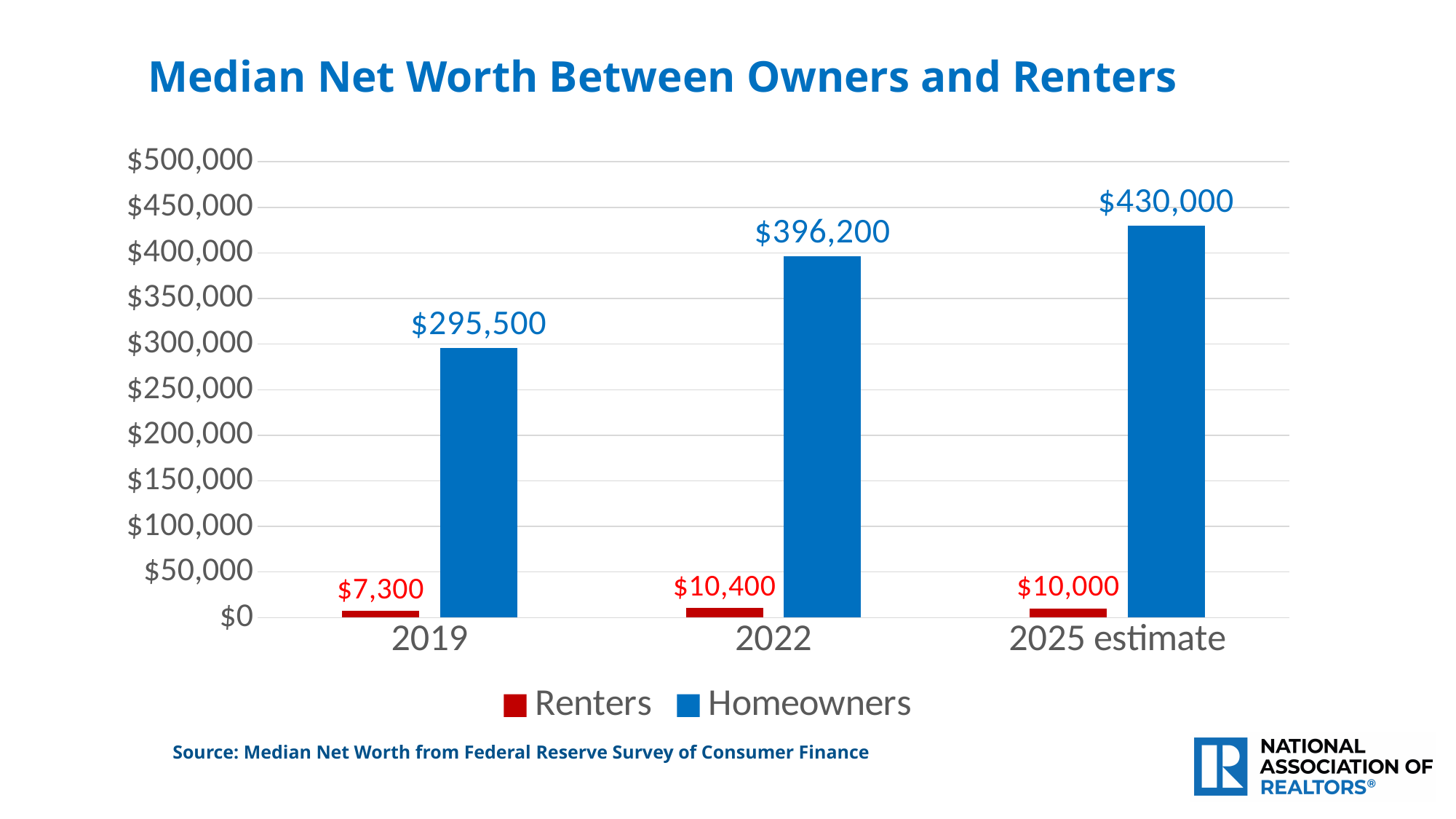
How many series does the legend list? 2 What is the difference between Homeowners and Renters median net worth in 2019? $288,200 Which is larger, the Renters value in 2022 or the Renters value in the 2025 estimate? 2022 Do the Homeowners values rise or fall from 2019 to the 2025 estimate? rise What is the median net worth of Homeowners in the 2025 estimate? $430,000 Is the Homeowners value for 2022 greater or less than $350,000? greater What is the median net worth of Renters in 2019? $7,300 In which year is the Renters median net worth lowest? 2019 What kind of chart is shown on the slide? bar chart In which year is the Homeowners median net worth highest? 2025 estimate How many categories are shown on the x axis? 3 What is the median net worth of Homeowners in 2022? $396,200